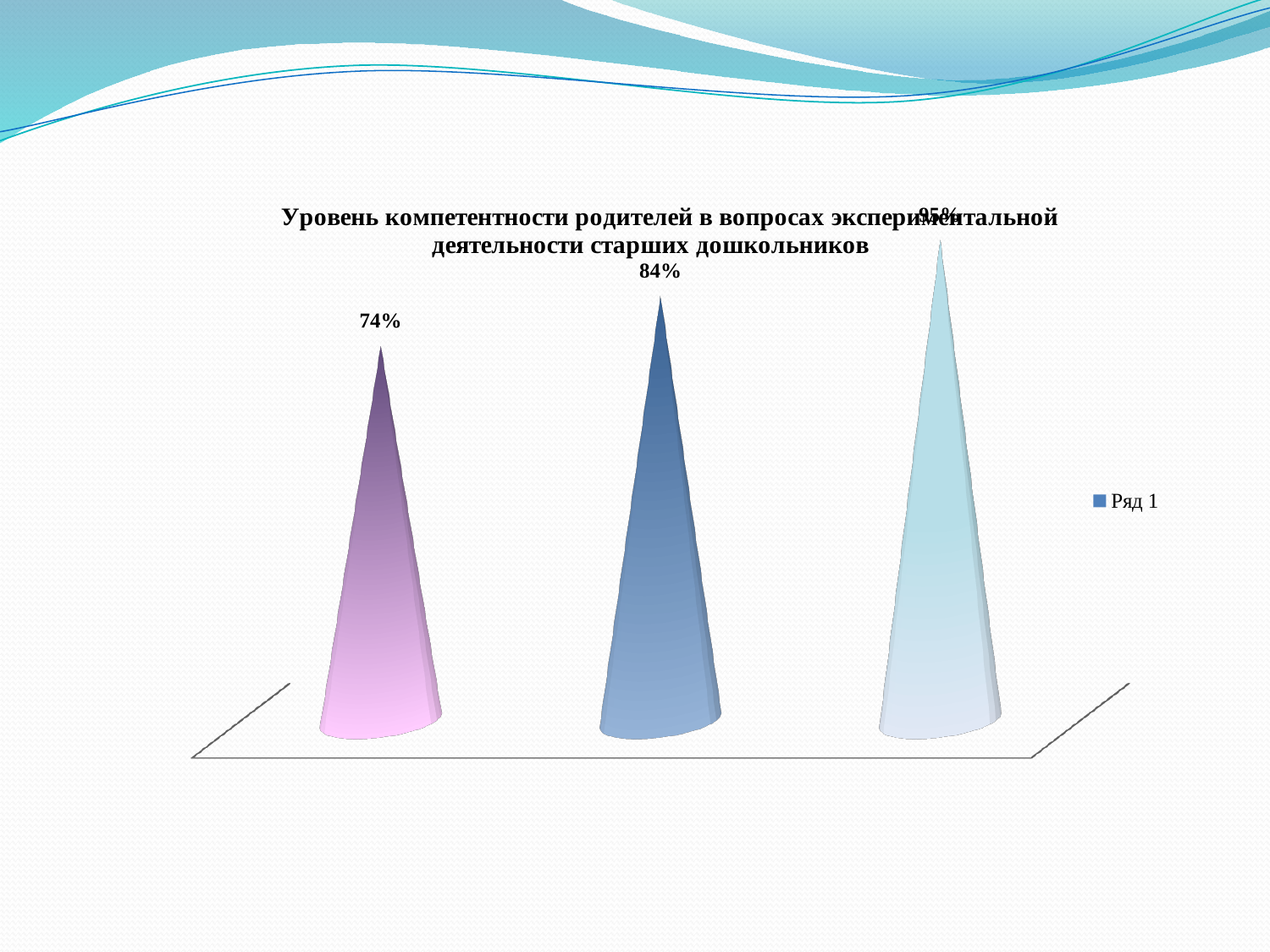
What kind of chart is shown on the slide? bar chart What is the difference between the middle bar's value and the left bar's value? 10% What is the value shown for the middle (dark blue) bar? 84% Which is larger, the value of the left bar or the value of the middle bar? the middle bar Which bar has the lowest value: the left, middle or right one? left Which bar has the highest value: the left, middle or right one? right What is the difference between the right bar's value and the middle bar's value? 11% What is the value shown for the right (light blue) bar? 95% What is the value shown for the left (pink) bar? 74% How many bars are plotted in the chart? 3 Do the values rise or fall from left to right across the chart? rise How many series does the legend list? 1